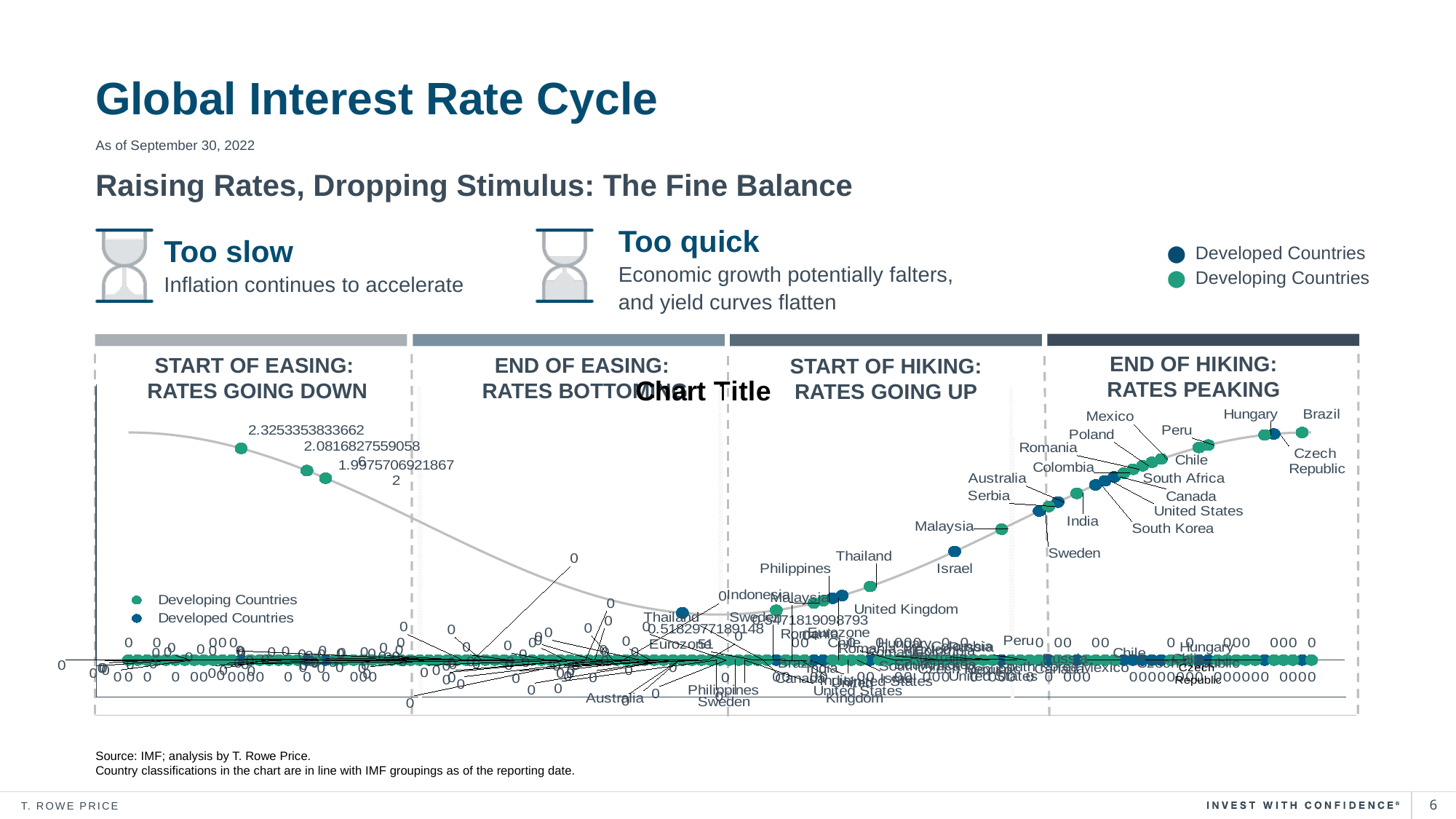
Does the curve rise or fall from the start of hiking section to the end of hiking section? Rise Which phase label appears at the far left of the chart? Start of easing: rates going down How many series does the chart legend list? 2 In which phase of the cycle is Malaysia plotted? Start of hiking: rates going up In which phase of the cycle is Brazil plotted? End of hiking: rates peaking What kind of chart is shown on the slide? Line chart In which phase of the cycle is Israel plotted? Start of hiking: rates going up How many phases of the interest rate cycle are labelled across the top of the chart? 4 What title is printed above the chart? Chart Title Which is plotted higher on the curve, Israel or Philippines? Israel Which is plotted higher on the curve, Malaysia or Thailand? Malaysia What are the two series named in the chart legend? Developing Countries and Developed Countries